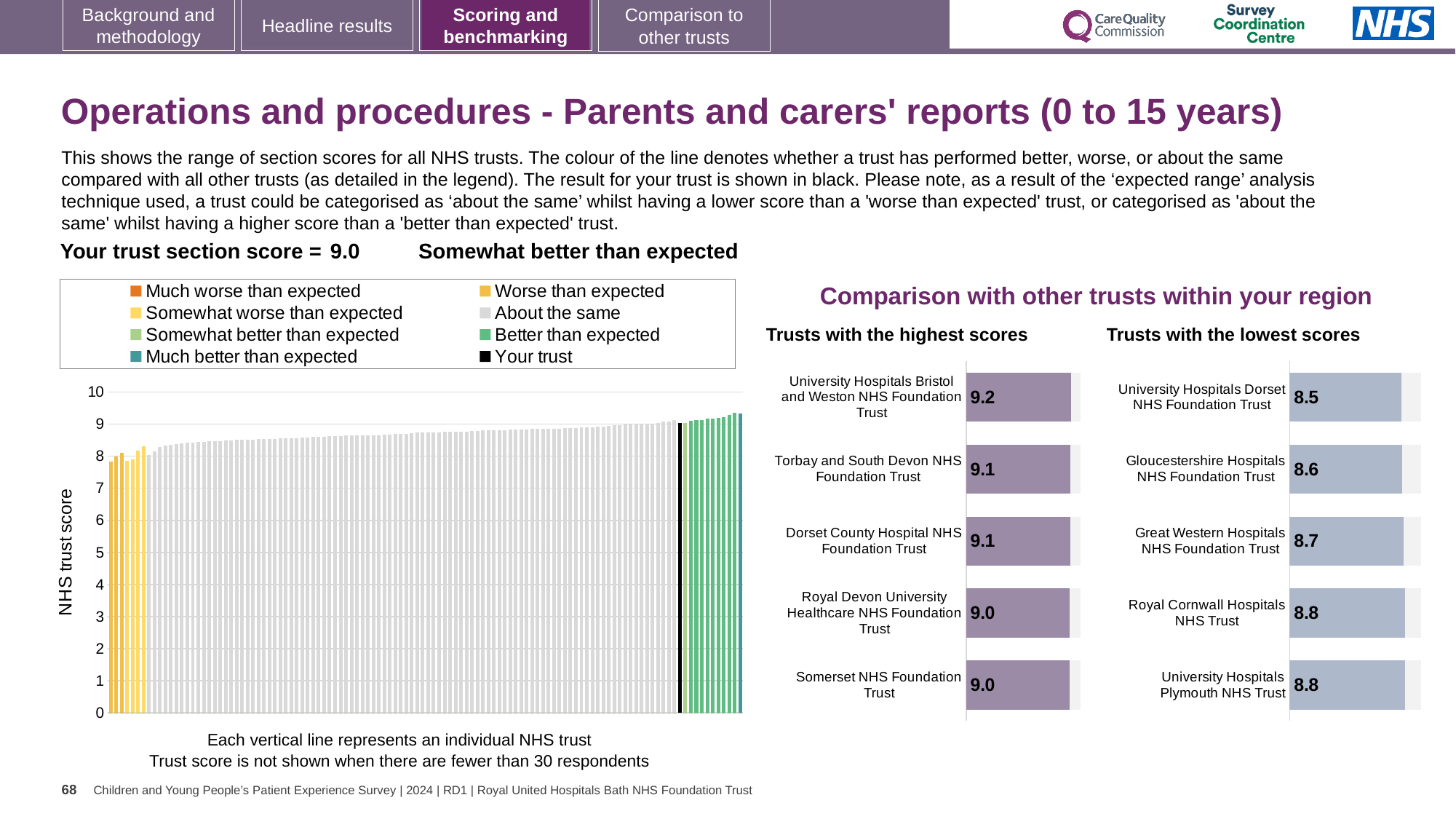
How many entries does the legend of the large chart on the left list? 8 How many trusts are shown in the 'Trusts with the lowest scores' chart? 5 In the 'Trusts with the highest scores' chart, what is the score for University Hospitals Bristol and Weston NHS Foundation Trust? 9.2 What kind of chart is the large chart on the left showing all NHS trusts? Bar chart According to the slide, what is your trust's section score shown in the large chart on the left? 9.0 In the 'Trusts with the lowest scores' chart, which trust has the lowest score? University Hospitals Dorset NHS Foundation Trust What is the label on the vertical axis of the large chart on the left? NHS trust score In the 'Trusts with the lowest scores' chart, what is the score for Great Western Hospitals NHS Foundation Trust? 8.7 In the 'Trusts with the highest scores' chart, what is the difference between the scores of University Hospitals Bristol and Weston NHS Foundation Trust and Somerset NHS Foundation Trust? 0.2 In the 'Trusts with the highest scores' chart, which trust has the highest score? University Hospitals Bristol and Weston NHS Foundation Trust How many trusts are shown in the 'Trusts with the highest scores' chart? 5 In the 'Trusts with the lowest scores' chart, which has the higher score: Gloucestershire Hospitals NHS Foundation Trust or Royal Cornwall Hospitals NHS Trust? Royal Cornwall Hospitals NHS Trust